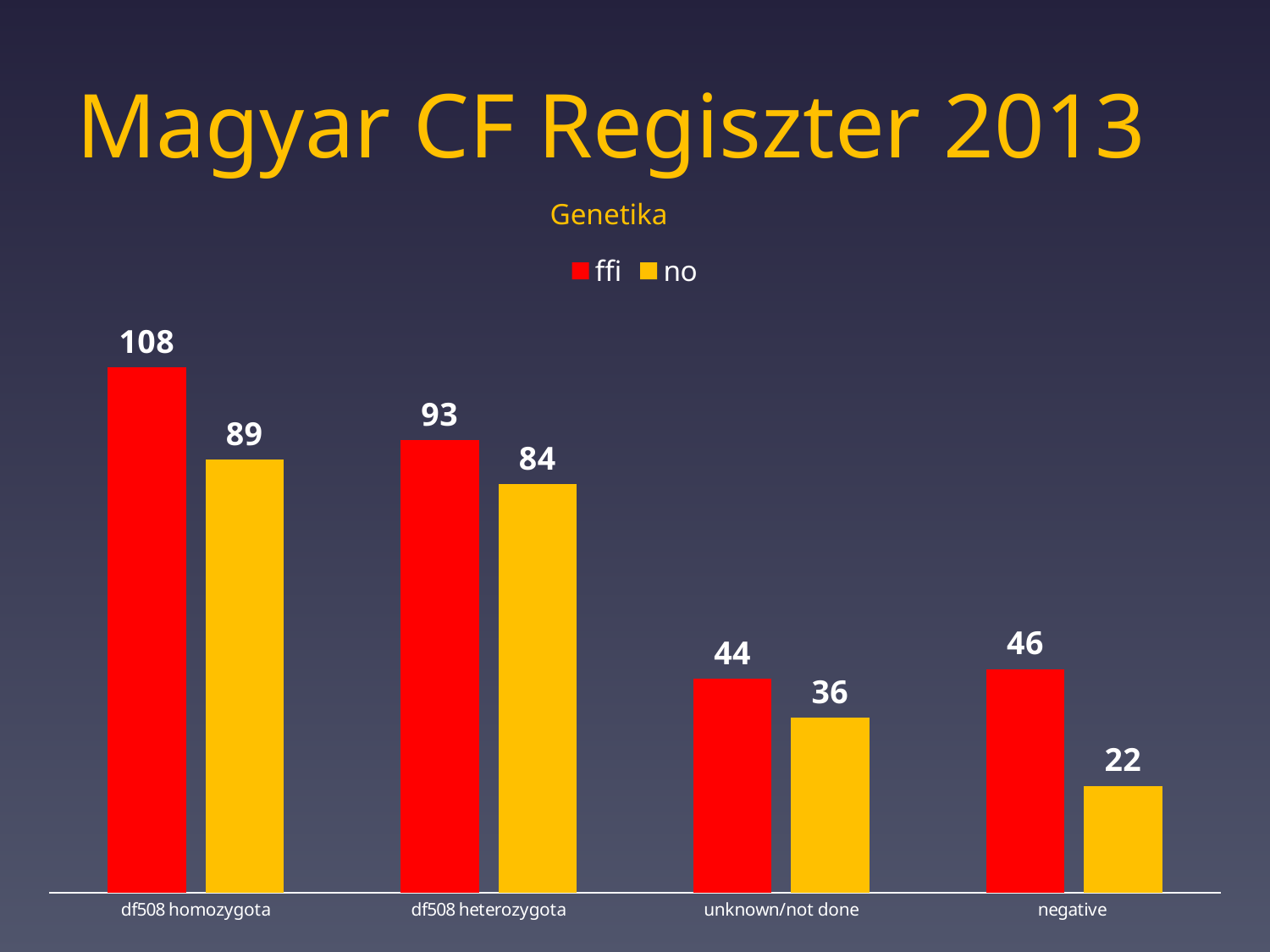
Which is larger, the no value for df508 homozygota or the no value for df508 heterozygota? df508 homozygota How many categories are shown on the x axis? 4 What is the value for no in the negative category? 22 What is the difference between the ffi values for df508 homozygota and df508 heterozygota? 15 Which category has the lowest no value? negative Which category has the highest ffi value? df508 homozygota What is the value for ffi in the df508 homozygota category? 108 What is the title of the chart? Genetika How many series does the legend list? 2 What kind of chart is shown on the slide? bar chart What is the value for no in the df508 heterozygota category? 84 What is the difference between the ffi and no values for unknown/not done? 8